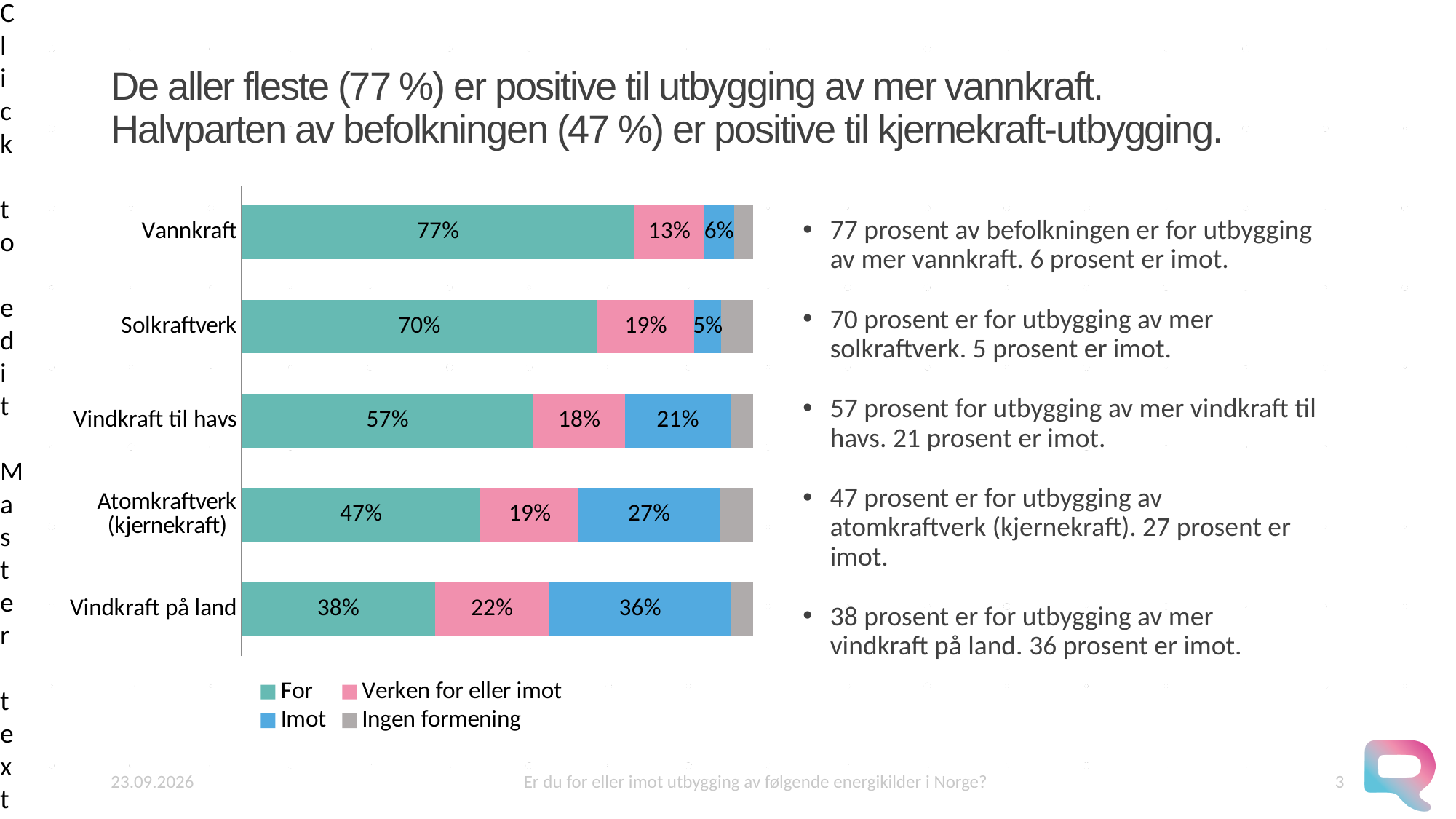
Which energy source has the highest 'For' value? Vannkraft Which is larger: the 'Imot' value for Vindkraft til havs or for Vindkraft på land? Vindkraft på land How many energy sources (categories) are shown in the chart? 5 What is the 'For' value for Vannkraft? 77% Which energy source has the lowest 'Imot' value? Solkraftverk What is the difference between the 'For' values for Vannkraft and Vindkraft på land? 39% What kind of chart is shown on the slide? Stacked bar chart What is the 'Imot' value for Atomkraftverk (kjernekraft)? 27% What is the 'Verken for eller imot' value for Vindkraft på land? 22% Do the 'For' values rise or fall going from the top bar (Vannkraft) to the bottom bar (Vindkraft på land)? Fall Which legend entry is shown in grey? Ingen formening How many series does the chart legend list? 4